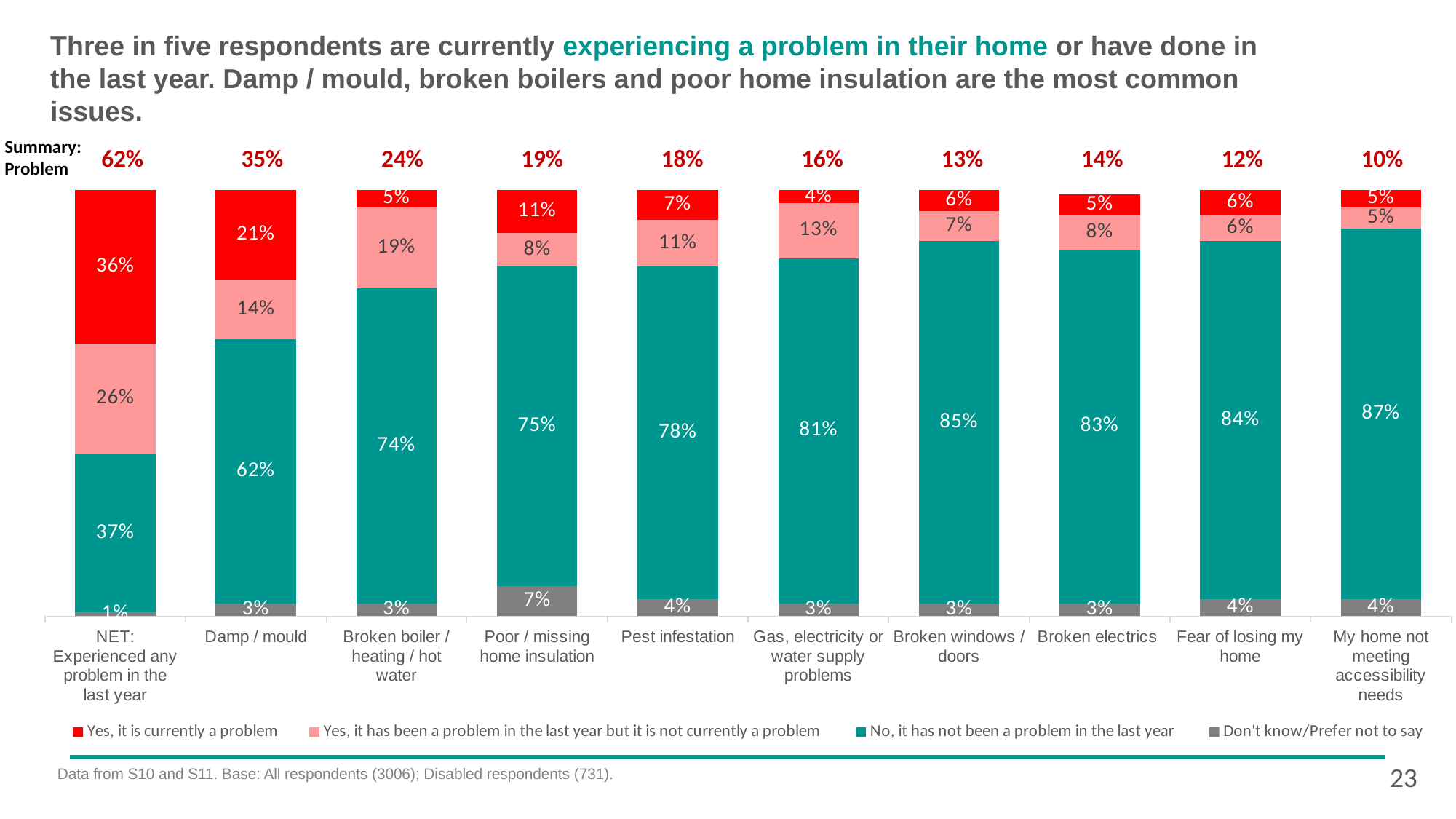
What percentage of respondents say a broken boiler / heating / hot water has not been a problem in the last year? 74% Which is larger: the 'has been a problem in the last year but not currently' value for broken boiler / heating / hot water or for gas, electricity or water supply problems? Broken boiler / heating / hot water Which colour represents 'Yes, it is currently a problem' in the legend? Red Which category has the highest 'No, it has not been a problem in the last year' value? My home not meeting accessibility needs What kind of chart is shown on the slide? Stacked bar chart How many categories are shown on the x axis of the chart? 10 Excluding the NET bar, which category has the lowest Summary: Problem figure? My home not meeting accessibility needs What is the Summary: Problem figure shown above the pest infestation bar? 18% How many series does the legend list? 4 What percentage of respondents say damp / mould is currently a problem? 21% What is the 'Don't know/Prefer not to say' value for poor / missing home insulation? 7% What is the difference between the 'currently a problem' values for damp / mould and poor / missing home insulation? 10%